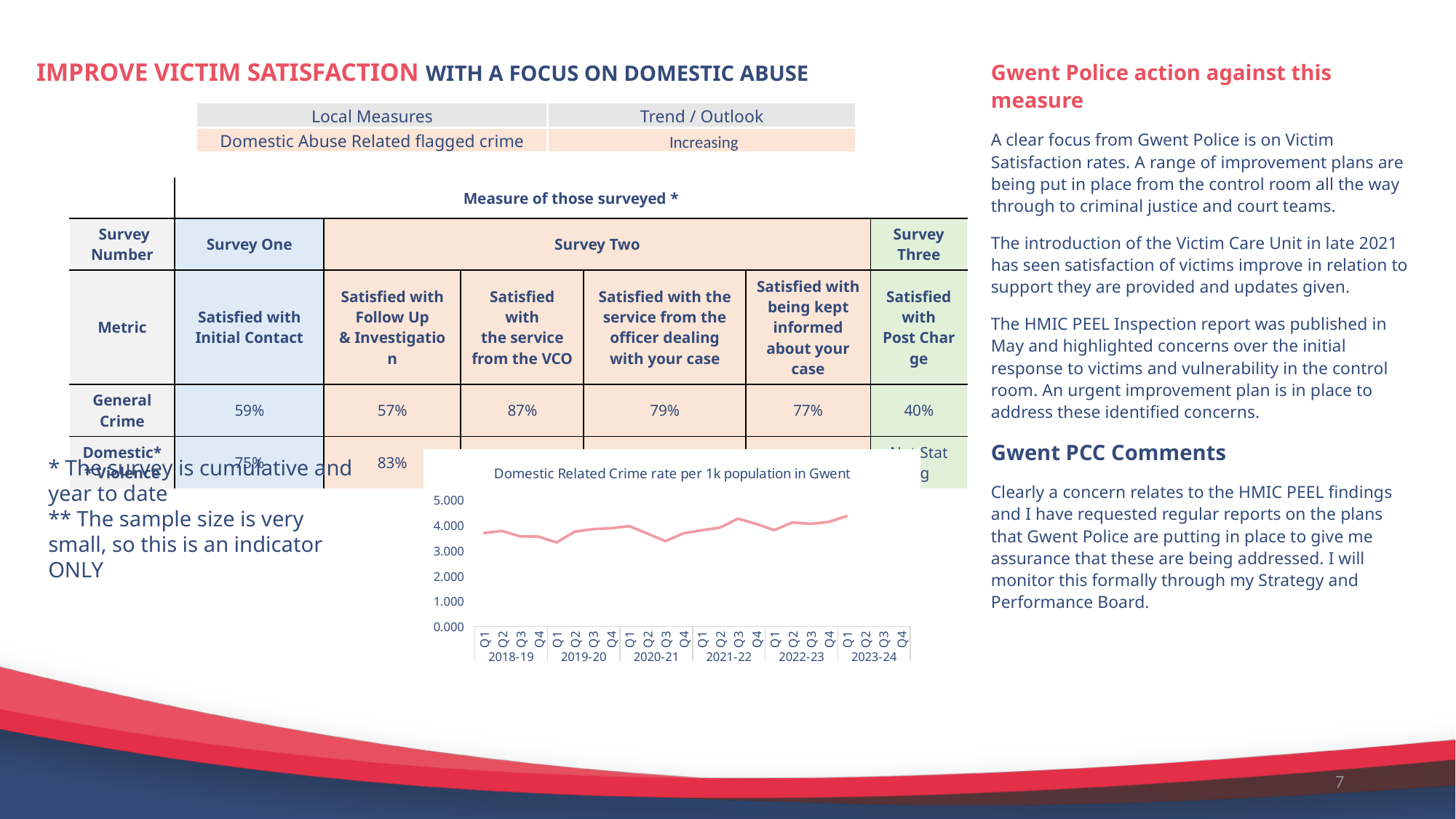
How many lines (series) are plotted on the chart? 1 Which is larger, the value for Q1 2023-24 or the value for Q1 2019-20? Q1 2023-24 Is the value for Q1 2019-20 greater or less than 4.000? less What is the highest value shown on the chart's y axis? 5.000 Overall, does the domestic related crime rate rise or fall from Q1 2018-19 to Q1 2023-24? rise Which is larger, the value for Q3 2021-22 or the value for Q3 2020-21? Q3 2021-22 Is the value for Q1 2018-19 greater or less than 4.000? less What kind of chart is shown on the slide? line chart Is the value for Q1 2023-24 greater or less than 4.000? greater What is the title of the chart on the slide? Domestic Related Crime rate per 1k population in Gwent How many financial years are labelled on the x axis of the chart? 6